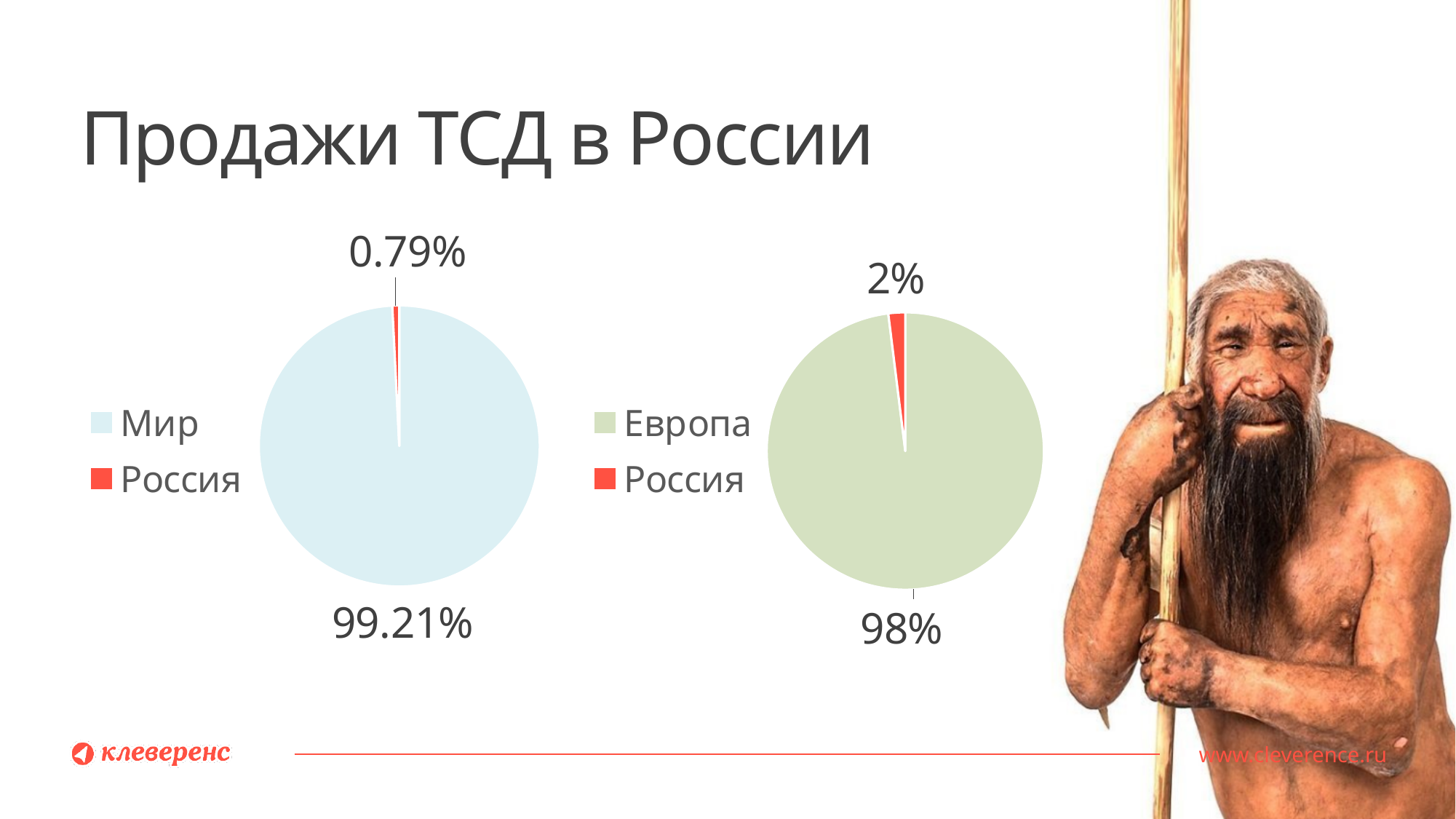
In the right pie chart (Европа / Россия), what is the difference between the Европа share and the Россия share? 96% In the right pie chart (Европа / Россия), which slice is the smallest? Россия In the right pie chart (Европа / Россия), what share does Россия have? 2% How many slices does the right pie chart (Европа / Россия) have? 2 In the left pie chart (Мир / Россия), what is the difference between the Мир share and the Россия share? 98.42% In the left pie chart (Мир / Россия), what share does Мир have? 99.21% What type of chart is used on the left side of the slide? pie chart In the right pie chart (Европа / Россия), what share does Европа have? 98% Is the Россия share larger in the left pie chart or in the right pie chart? right pie chart What is the title of the slide containing the two pie charts? Продажи ТСД в России In the left pie chart (Мир / Россия), what share does Россия have? 0.79% In the left pie chart (Мир / Россия), which slice is the largest? Мир